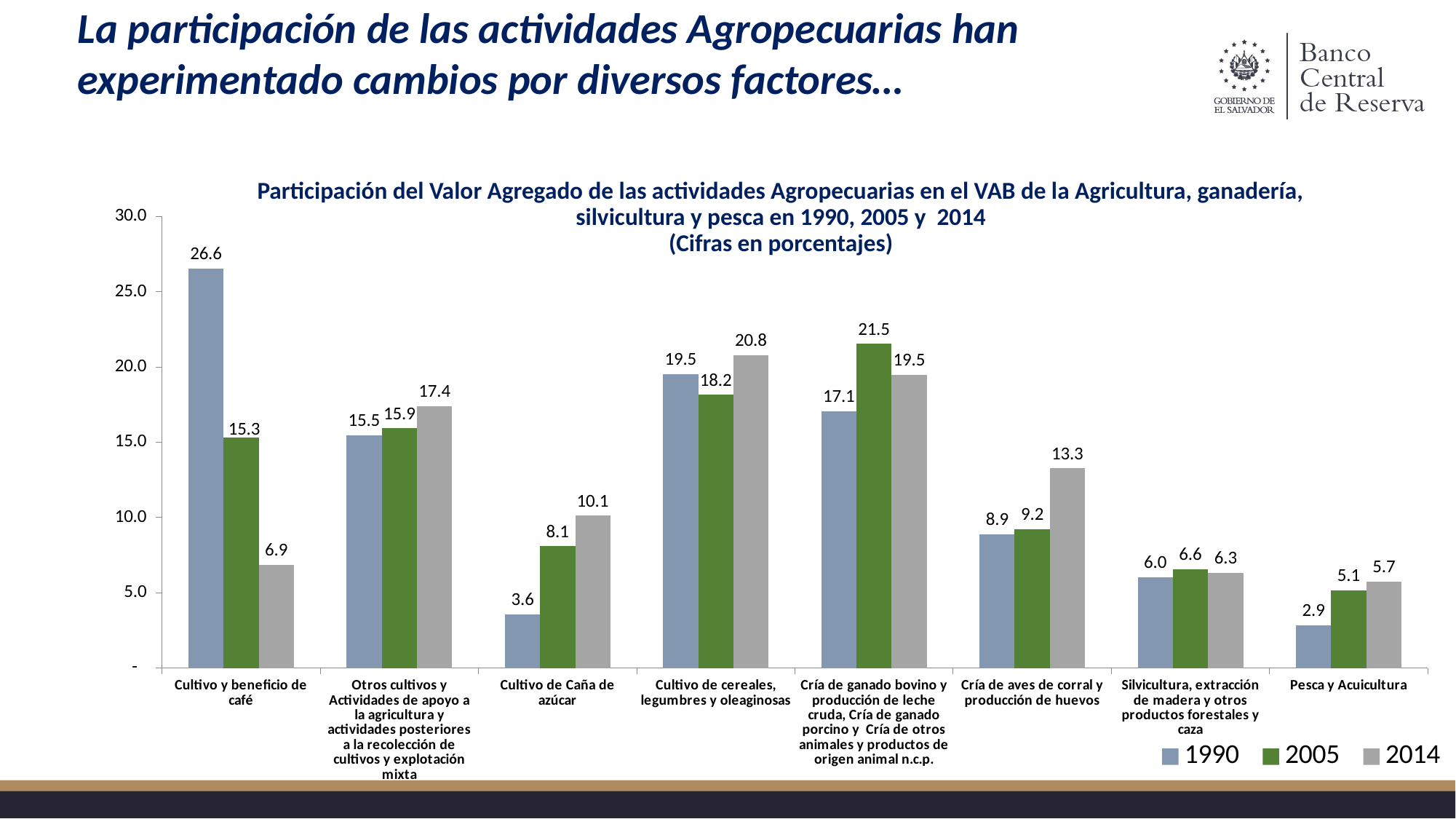
How many categories are shown on the x axis? 8 What is the value for Pesca y Acuicultura in 2014? 5.7 Which category has the highest value in the 2014 series? Cultivo de cereales, legumbres y oleaginosas Which category has the lowest value in the 1990 series? Pesca y Acuicultura Which colour represents the 2005 series in the legend? Green How many series does the legend list? 3 What is the value for Cultivo de Caña de azúcar in 2005? 8.1 What is the value for Cultivo y beneficio de café in 1990? 26.6 What kind of chart is shown on the slide? Bar chart Does the value for Cultivo de Caña de azúcar rise or fall from 1990 to 2014? Rise Which is larger for Cría de aves de corral y producción de huevos: the 2005 value or the 2014 value? 2014 What is the difference between the 1990 and 2014 values for Cultivo y beneficio de café? 19.7